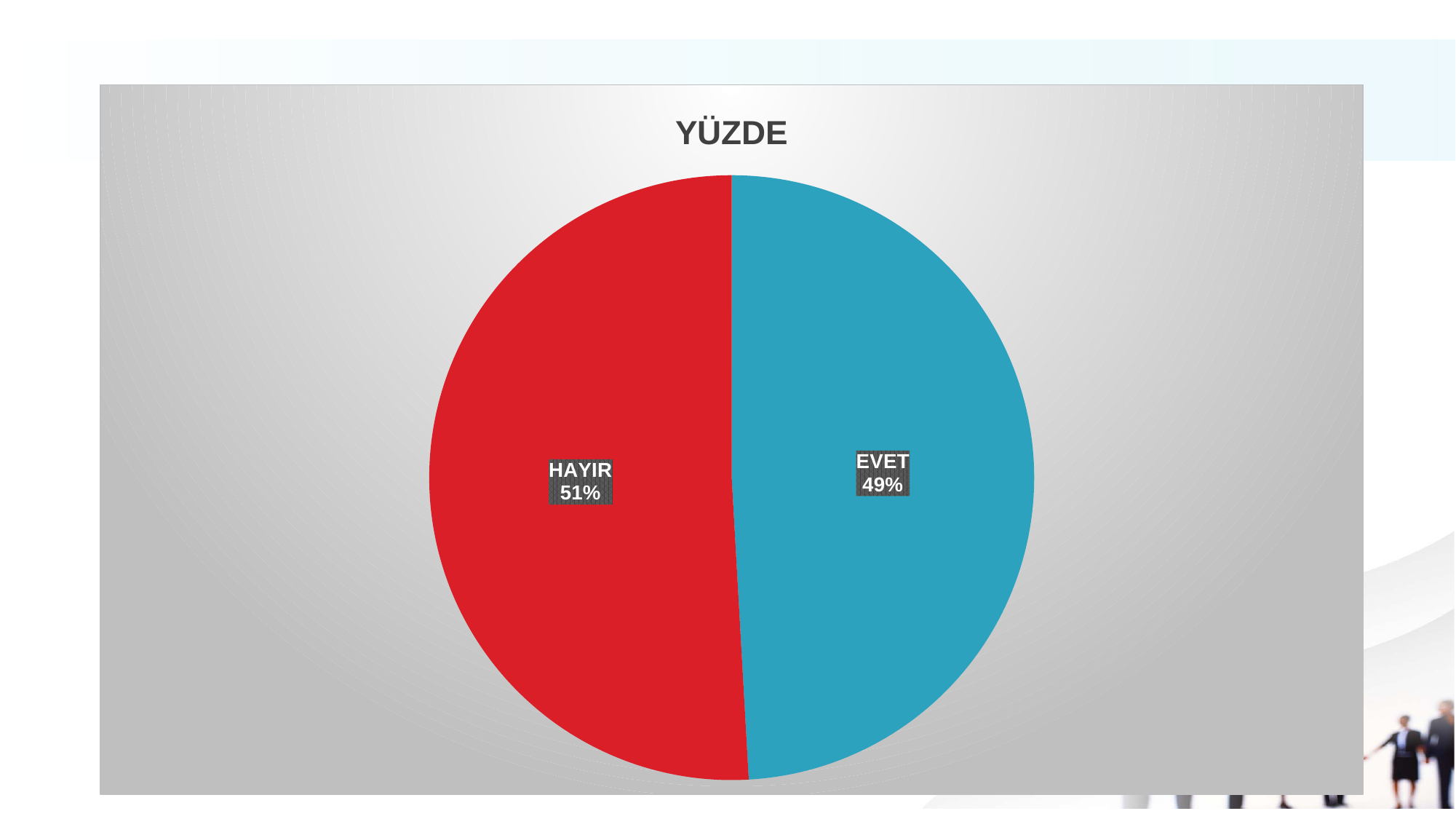
What is the difference in percentage points between HAYIR and EVET? 2 What is the title of the chart? YÜZDE Which slice is the smallest in the pie chart? EVET What share of the pie does EVET have? 49% Which slice is the largest in the pie chart? HAYIR What colour is the HAYIR slice? red Which is larger, HAYIR or EVET? HAYIR What share of the pie does HAYIR have? 51% Is the share for EVET greater or less than 50%? less How many slices does the pie chart have? 2 What kind of chart is shown on the slide? pie chart